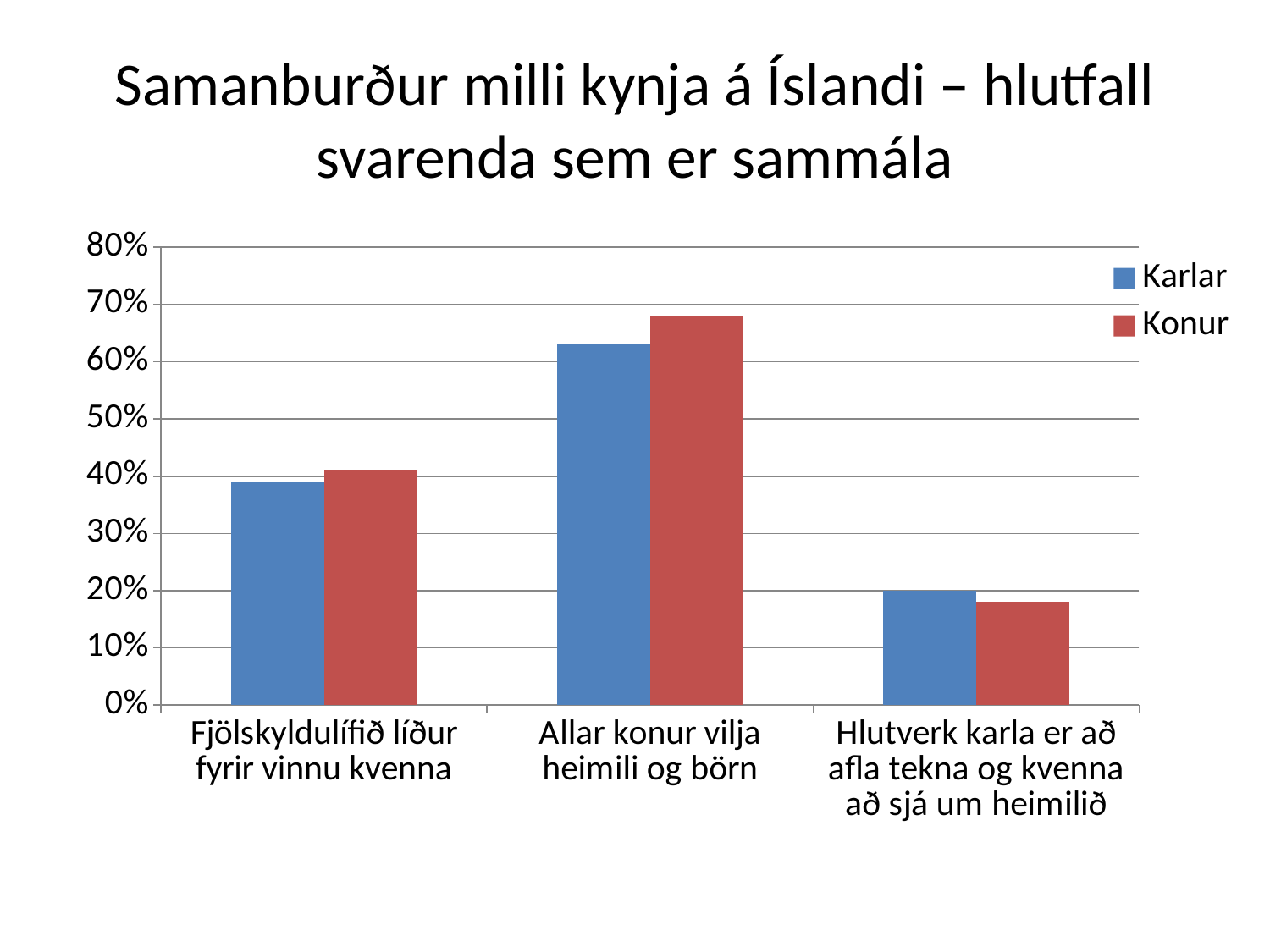
How many categories are shown on the x axis? 3 In the category 'Hlutverk karla er að afla tekna og kvenna að sjá um heimilið', which series has the larger value, Karlar or Konur? Karlar What are the two series named in the legend? Karlar and Konur What kind of chart is shown on the slide? bar chart Is the value for Karlar in the category 'Fjölskyldulífið líður fyrir vinnu kvenna' greater or less than 50%? less Is the value for Konur in the category 'Hlutverk karla er að afla tekna og kvenna að sjá um heimilið' greater or less than 20%? less How many series does the legend list? 2 In the category 'Allar konur vilja heimili og börn', which series has the larger value, Karlar or Konur? Konur Is the value for Konur in the category 'Allar konur vilja heimili og börn' greater or less than 60%? greater Which category has the lowest value for Konur? Hlutverk karla er að afla tekna og kvenna að sjá um heimilið Which category has the highest value for Karlar? Allar konur vilja heimili og börn What colour are the bars for the Konur series? red